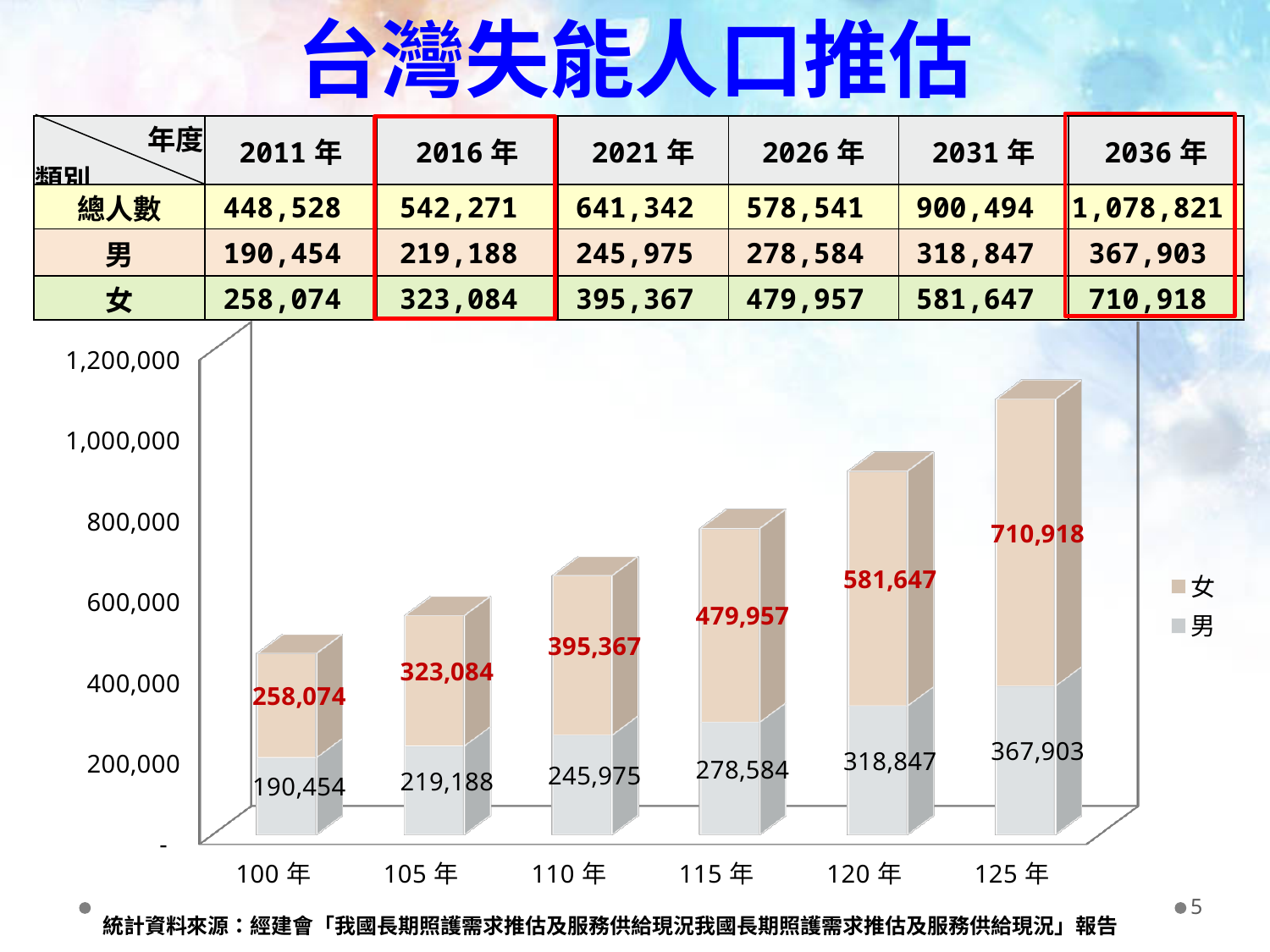
Which year category has the lowest value for 女 in the chart? 100 年 Which year category has the highest value for 男 in the chart? 125 年 How many year categories are plotted along the x axis of the chart? 6 Which is larger in the chart: 女 for 105 年 or 男 for 120 年? 女 for 105 年 How many series does the chart legend list? 2 What is the difference between the 女 and 男 values for 125 年 in the chart? 343,015 What is the total of the stacked bar for 100 年 in the chart? 448,528 What is the value of 男 for 110 年 in the chart? 245,975 What is the value of 女 for 115 年 in the chart? 479,957 What is the value of 女 for 125 年 in the chart? 710,918 Do the 女 values rise or fall from 100 年 to 125 年 along the x axis? rise What kind of chart is shown on the slide? stacked bar chart